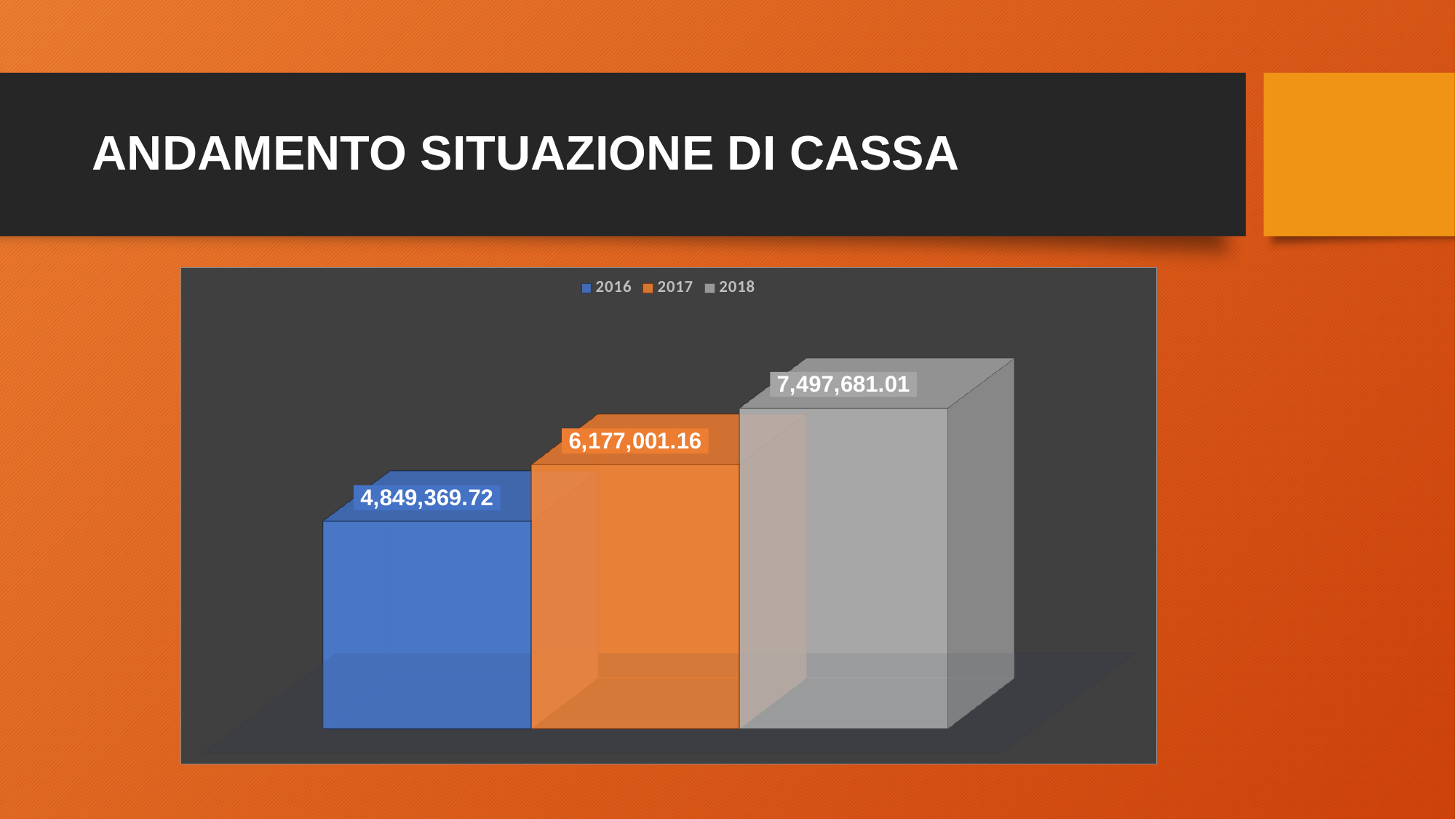
What is the value shown for 2016? 4,849,369.72 Which is larger, the value for 2016 or the value for 2018? 2018 Which year has the highest value? 2018 What is the value shown for 2017? 6,177,001.16 What kind of chart is shown on the slide? Bar chart How many series does the legend list? 3 What is the difference between the 2018 value and the 2016 value? 2,648,311.29 What is the difference between the 2018 value and the 2017 value? 1,320,679.85 What is the difference between the 2017 value and the 2016 value? 1,327,631.44 Which year has the lowest value? 2016 Do the values rise or fall from 2016 to 2018? Rise What is the value shown for 2018? 7,497,681.01